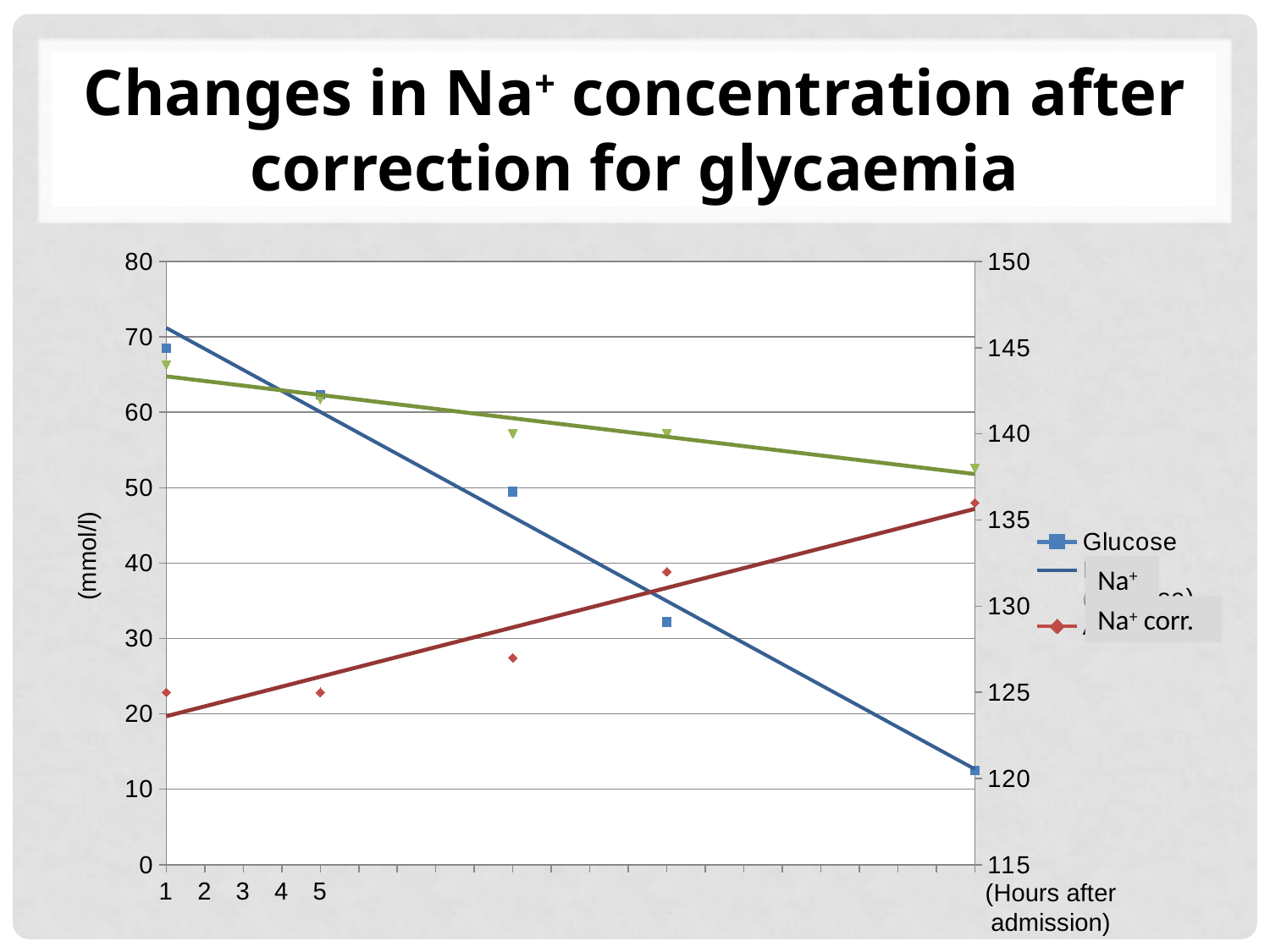
What kind of chart is shown on the slide? line chart Does the Glucose series rise or fall over the hours after admission? fall Is the Na+ corr. value at the last plotted point greater or less than 130 on the right axis? greater Is the Na+ value at hour 1 greater or less than 140 on the right axis? greater Does the Na+ series rise or fall over the hours after admission? fall What is the title of the chart? Changes in Na+ concentration after correction for glycaemia How many series does the legend list? 3 Is the Glucose value at hour 1 greater or less than 60? greater At which hour is the Glucose value highest? 1 Does the Na+ corr. series rise or fall over the hours after admission? rise What is the label on the left vertical axis? (mmol/l)